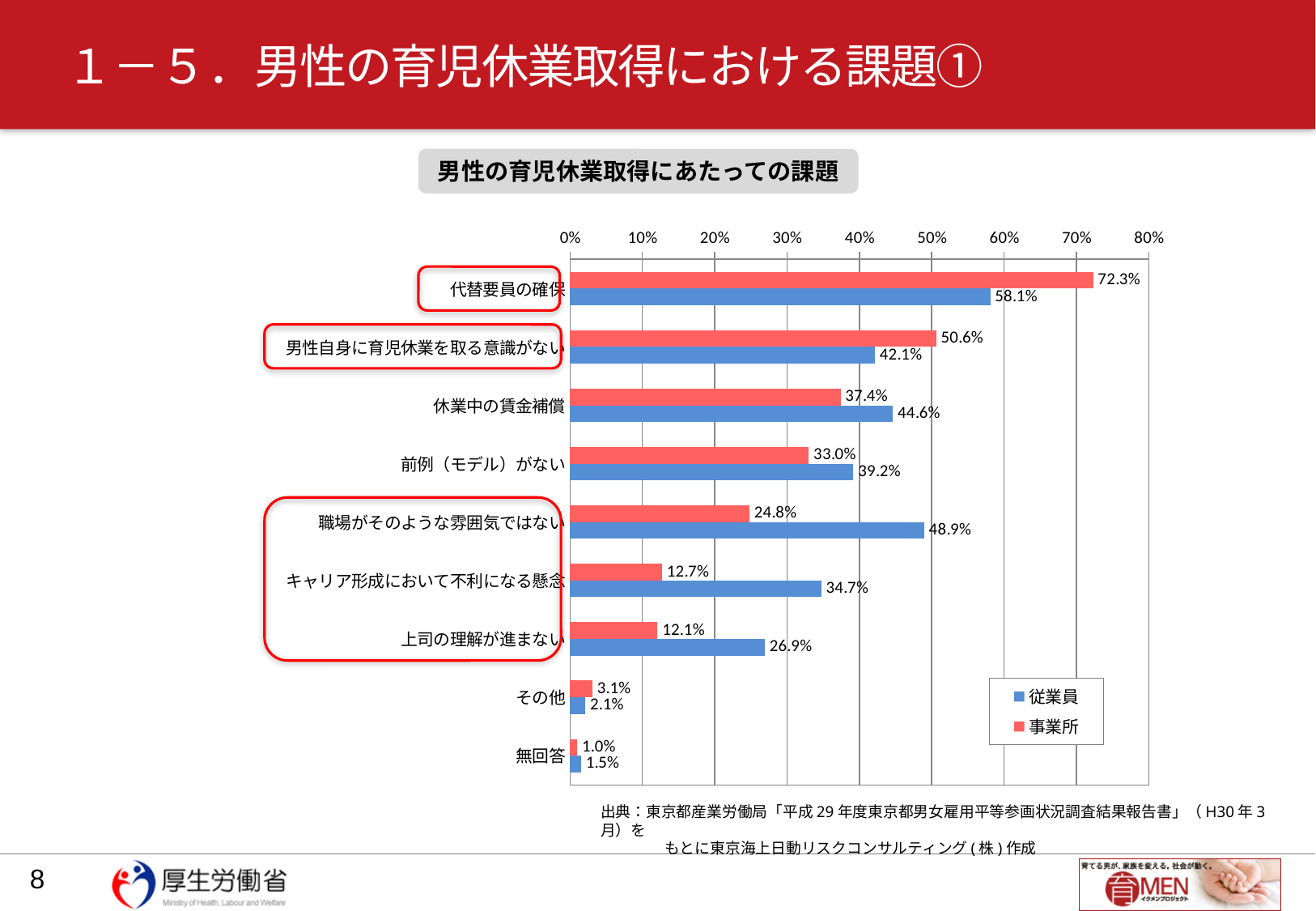
What kind of chart is shown on the slide? Bar chart How many series does the legend list? 2 What is the difference between the 事業所 and 従業員 values for 代替要員の確保? 14.2% Which category has the highest 事業所 value? 代替要員の確保 Which category has the lowest 従業員 value? 無回答 What is the difference between the 従業員 and 事業所 values for キャリア形成において不利になる懸念? 22.0% What is the 事業所 value for 代替要員の確保? 72.3% What is the 従業員 value for 休業中の賃金補償? 44.6% What is the 従業員 value for 職場がそのような雰囲気ではない? 48.9% For 前例（モデル）がない, which series has the larger value, 従業員 or 事業所? 従業員 Which colour represents the 事業所 series? Red How many categories are shown on the chart? 9